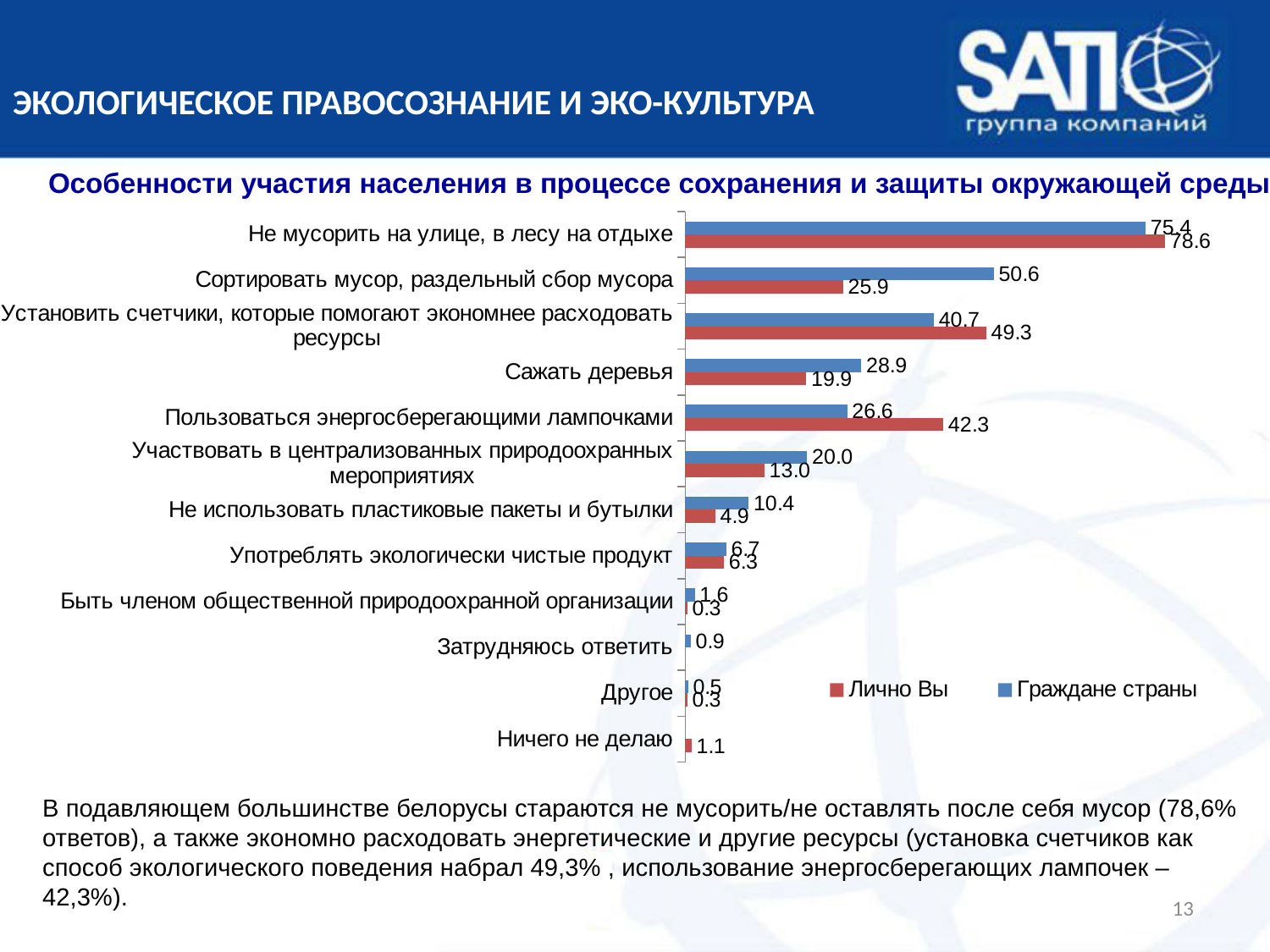
How many categories are shown on the chart? 12 Which category has the highest value for the "Лично Вы" series? Не мусорить на улице, в лесу на отдыхе What is the value for "Лично Вы" in the category "Не мусорить на улице, в лесу на отдыхе"? 78.6 How many series does the legend list? 2 For "Сажать деревья", which series has the larger value: "Лично Вы" or "Граждане страны"? Граждане страны What is the value for "Граждане страны" in the category "Сортировать мусор, раздельный сбор мусора"? 50.6 For "Установить счетчики, которые помогают экономнее расходовать ресурсы", which series has the larger value: "Лично Вы" or "Граждане страны"? Лично Вы What is the difference between the "Граждане страны" and "Лично Вы" values for "Сортировать мусор, раздельный сбор мусора"? 24.7 Which series is shown in red on the chart? Лично Вы Which category has the lowest value for the "Граждане страны" series? Другое What kind of chart is shown on the slide? Bar chart What is the value for "Лично Вы" in the category "Пользоваться энергосберегающими лампочками"? 42.3